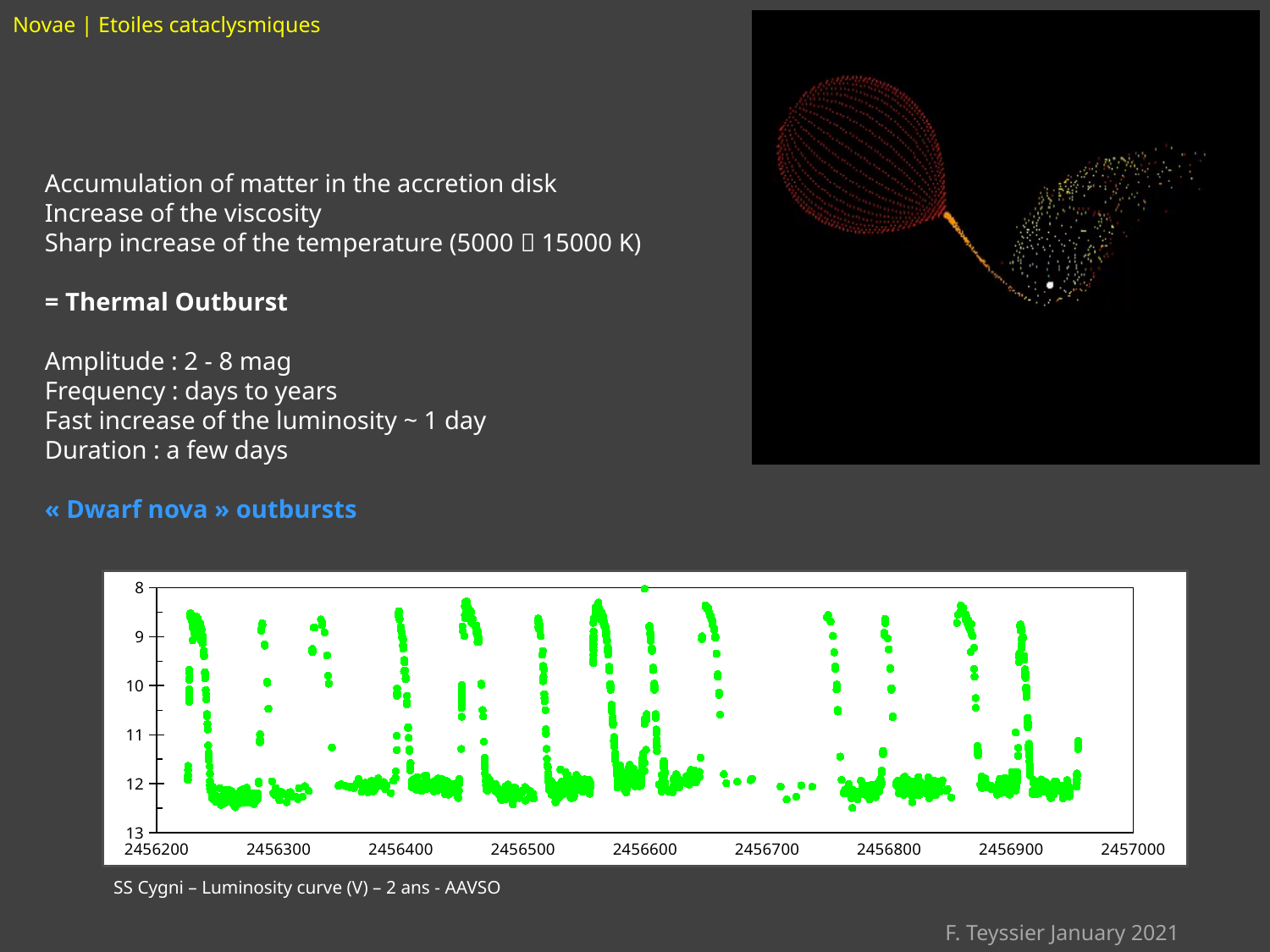
What kind of chart is shown at the bottom of the slide? scatter chart What is the spacing between consecutive tick labels on the x axis of the chart? 100 Is the y-axis value of the highest point in the chart, near x = 2456600, greater or less than 9? less How many tick labels are printed on the x axis of the chart? 9 What is the leftmost tick label on the x axis of the chart? 2456200 What is the rightmost tick label on the x axis of the chart? 2457000 What colour are the data points in the chart? green What is the caption printed below the chart? SS Cygni – Luminosity curve (V) – 2 ans - AAVSO What is the topmost tick label on the y axis of the chart? 8 What is the bottommost tick label on the y axis of the chart? 13 Is the y-axis value of the dense band of points near x = 2456300 greater or less than 11? greater How many tick labels are printed on the y axis of the chart? 6